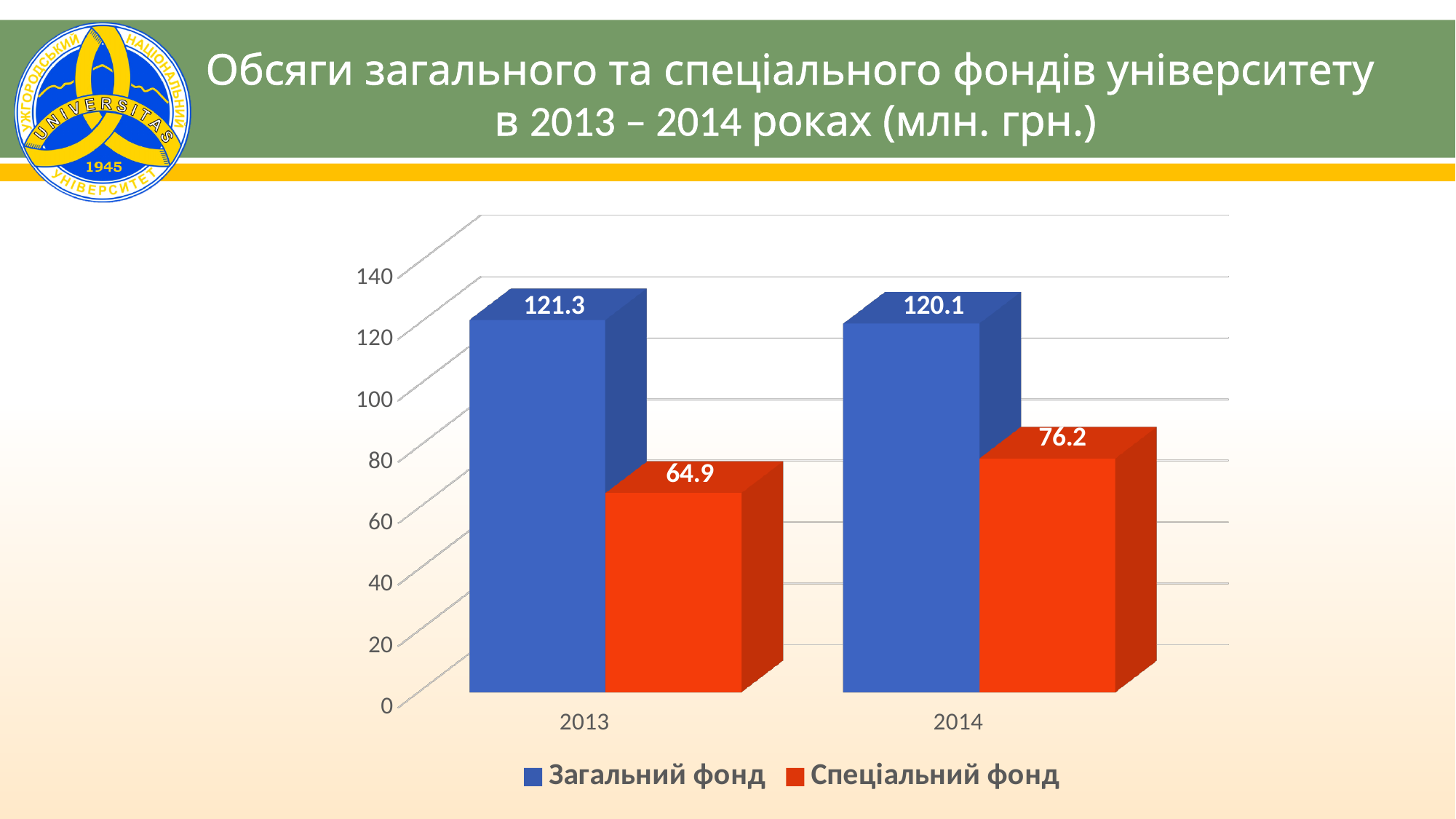
What kind of chart is shown on the slide? Bar chart What is the value of Спеціальний фонд for 2014? 76.2 What is the value of Загальний фонд for 2013? 121.3 Which is larger in 2014: Загальний фонд or Спеціальний фонд? Загальний фонд Does Спеціальний фонд rise or fall from 2013 to 2014? Rise What is the value of Спеціальний фонд for 2013? 64.9 What is the difference between Загальний фонд and Спеціальний фонд in 2013? 56.4 What is the value of Загальний фонд for 2014? 120.1 In which year is Загальний фонд lowest? 2014 By how much did Спеціальний фонд increase from 2013 to 2014? 11.3 How many series does the legend list? 2 In which year is Спеціальний фонд highest? 2014